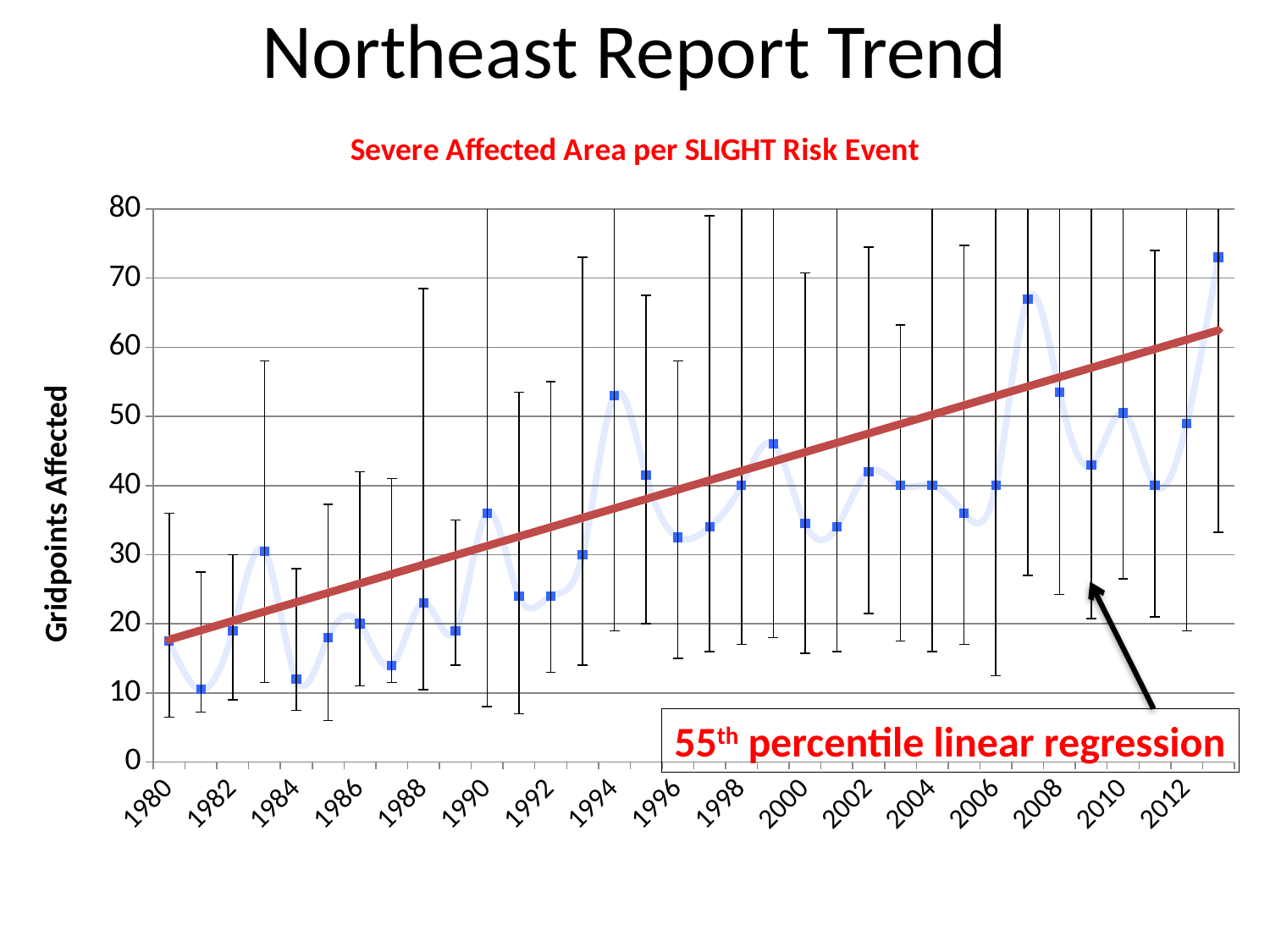
Which is larger, the value for 2007 or the value for 2008? 2007 Which year has the highest value of gridpoints affected? 2013 Is the value for 2007 greater or less than 60? greater Is the value for 2013 greater or less than 70? greater What is the label of the vertical axis? Gridpoints Affected What is the title of the chart? Severe Affected Area per SLIGHT Risk Event Does the red regression line rise or fall from 1980 to 2013? rises How many yearly data points are plotted on the chart? 34 Is the value for 1994 greater or less than 50? greater What kind of chart is shown on the slide? line chart